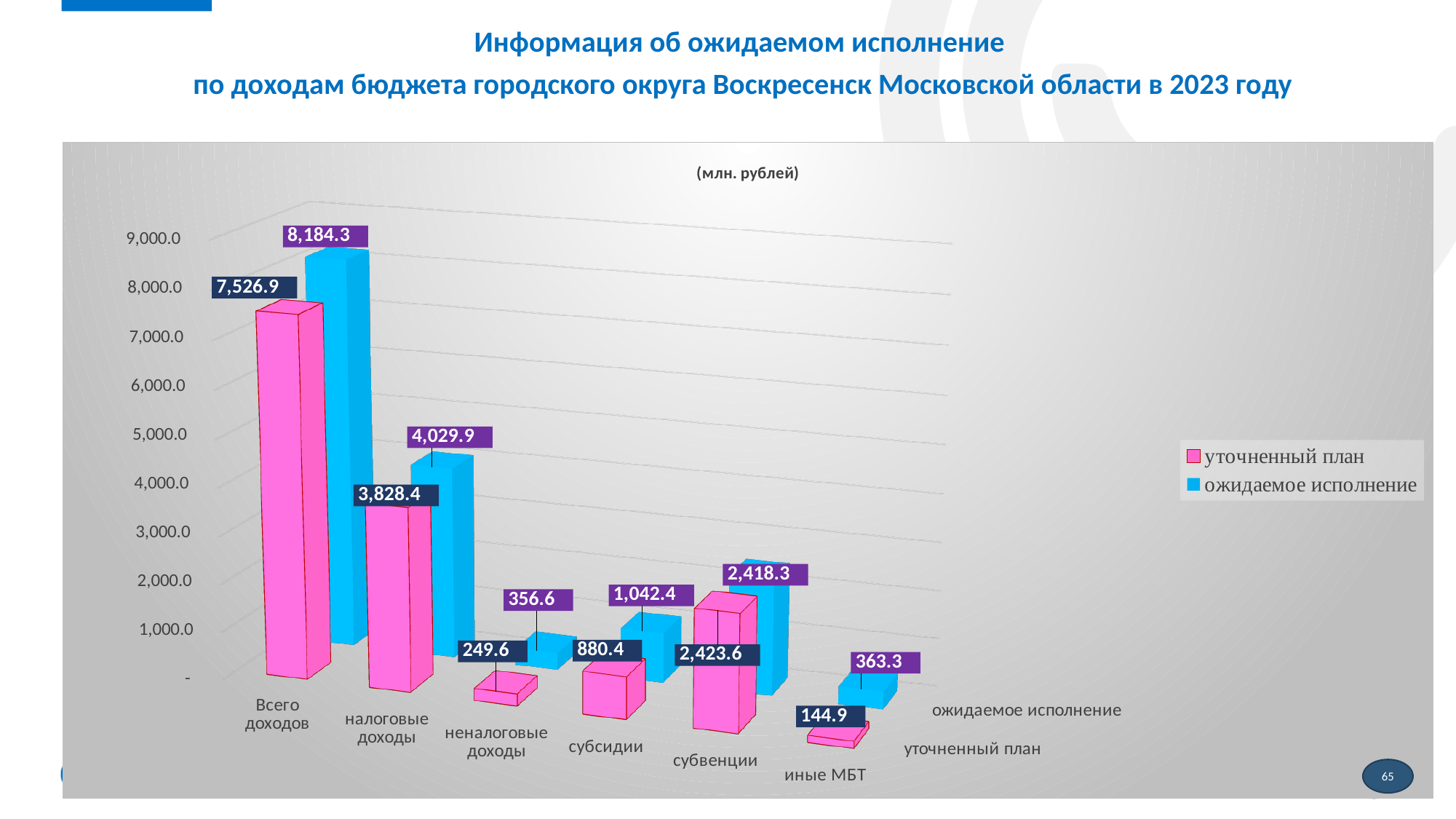
Which category has the highest 'ожидаемое исполнение' value? Всего доходов Which is larger for 'иные МБТ': 'уточненный план' or 'ожидаемое исполнение'? ожидаемое исполнение What is the difference between 'ожидаемое исполнение' and 'уточненный план' for 'неналоговые доходы'? 107.0 What is the difference between 'ожидаемое исполнение' and 'уточненный план' for 'Всего доходов'? 657.4 What is the value of 'ожидаемое исполнение' for 'субсидии'? 1,042.4 What is the value of 'ожидаемое исполнение' for 'Всего доходов'? 8,184.3 What is the value of 'уточненный план' for 'налоговые доходы'? 3,828.4 What kind of chart is shown on the slide? bar chart How many series does the legend list? 2 What is the value of 'уточненный план' for 'иные МБТ'? 144.9 Which category has the lowest 'уточненный план' value? иные МБТ How many categories are shown on the x axis? 6